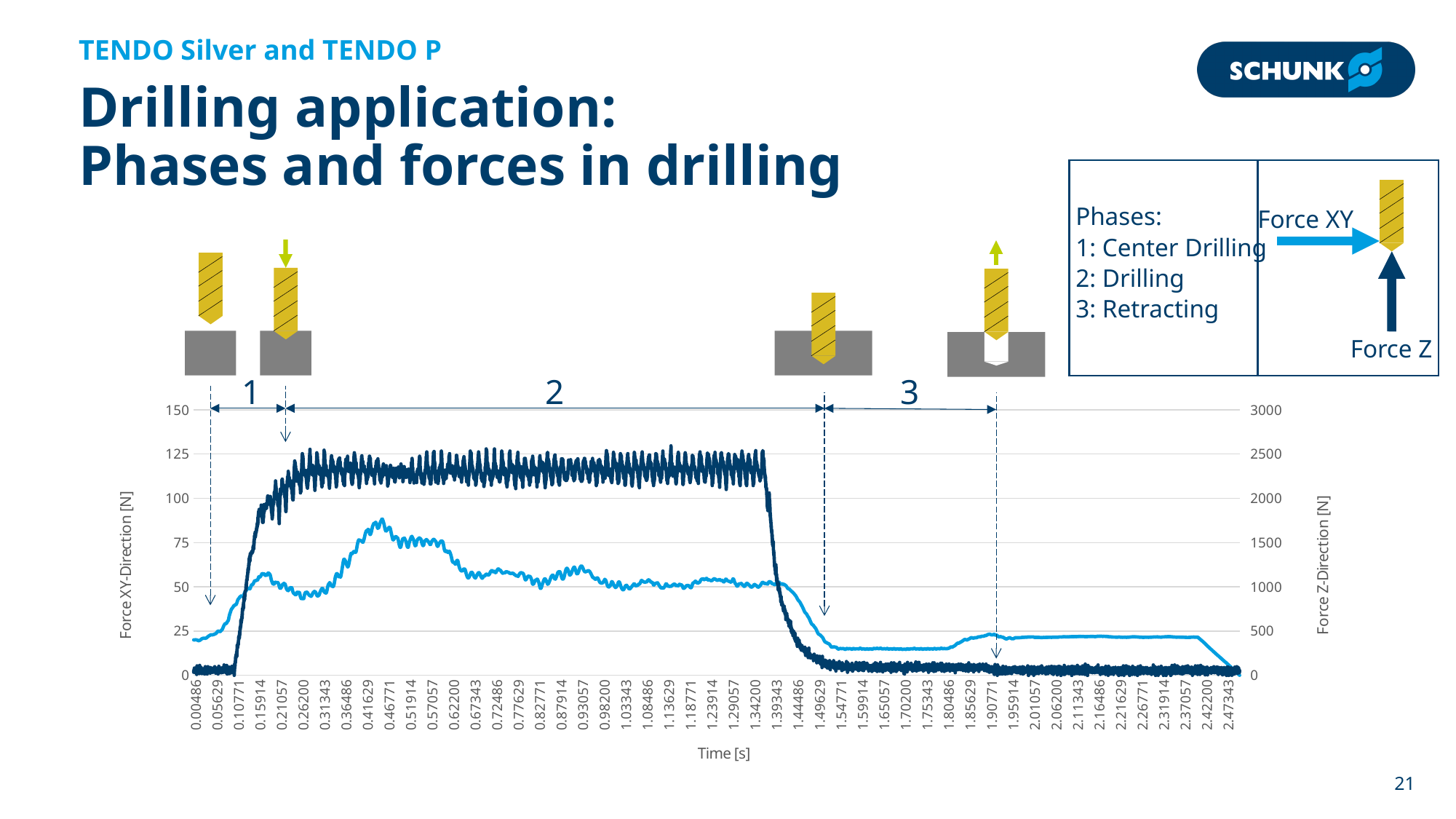
What kind of chart is shown on the slide? line chart What is the highest tick value shown on the left vertical axis (Force XY-Direction)? 150 What is the label of the right vertical axis of the chart? Force Z-Direction [N] How many drilling phases are marked above the chart? 3 What is the label of the left vertical axis of the chart? Force XY-Direction [N] Is the Force Z-Direction value at the start of the chart (around 0.00486 s) greater or less than 500 on the right axis? less Is the Force Z-Direction value during phase 2 (around time 0.8 s) greater or less than 2000 on the right axis? greater Is the Force XY-Direction value at around 2.0 s greater or less than 50? less What is the highest tick value shown on the right vertical axis (Force Z-Direction)? 3000 Does the Force Z-Direction line rise or fall between about 1.34 s and 1.49 s? fall Does the Force Z-Direction line rise or fall between about 0.10 s and 0.21 s? rise